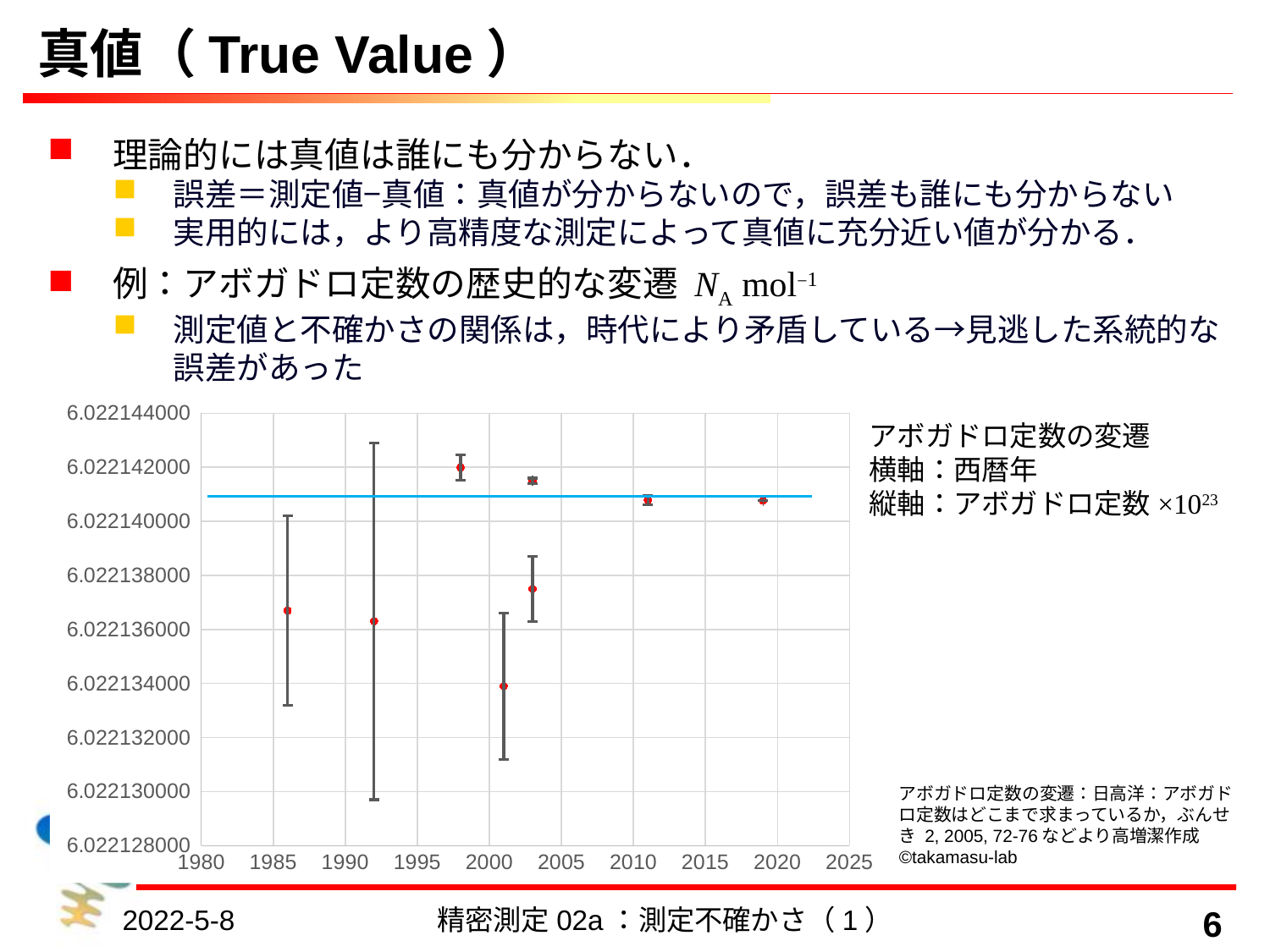
What is the lowest value shown on the vertical axis of the chart? 6.0221280000 Is the plotted value around 1986 greater or less than 6.0221138000? greater What is the highest value shown on the vertical axis of the chart? 6.0221440000 Which plotted value is larger, the one around 1998 or the one around 2001? 1998 Around which year does the point have the largest error bar? 1992 Is the plotted value around 1998 greater or less than 6.0221140000? greater Is the plotted value around 2001 greater or less than 6.0221136000? greater What kind of chart is shown on the slide? scatter chart with error bars Around which year is the highest plotted Avogadro constant value? 1998 How many data points are plotted in the chart? 8 Around which year is the lowest plotted Avogadro constant value? 2001